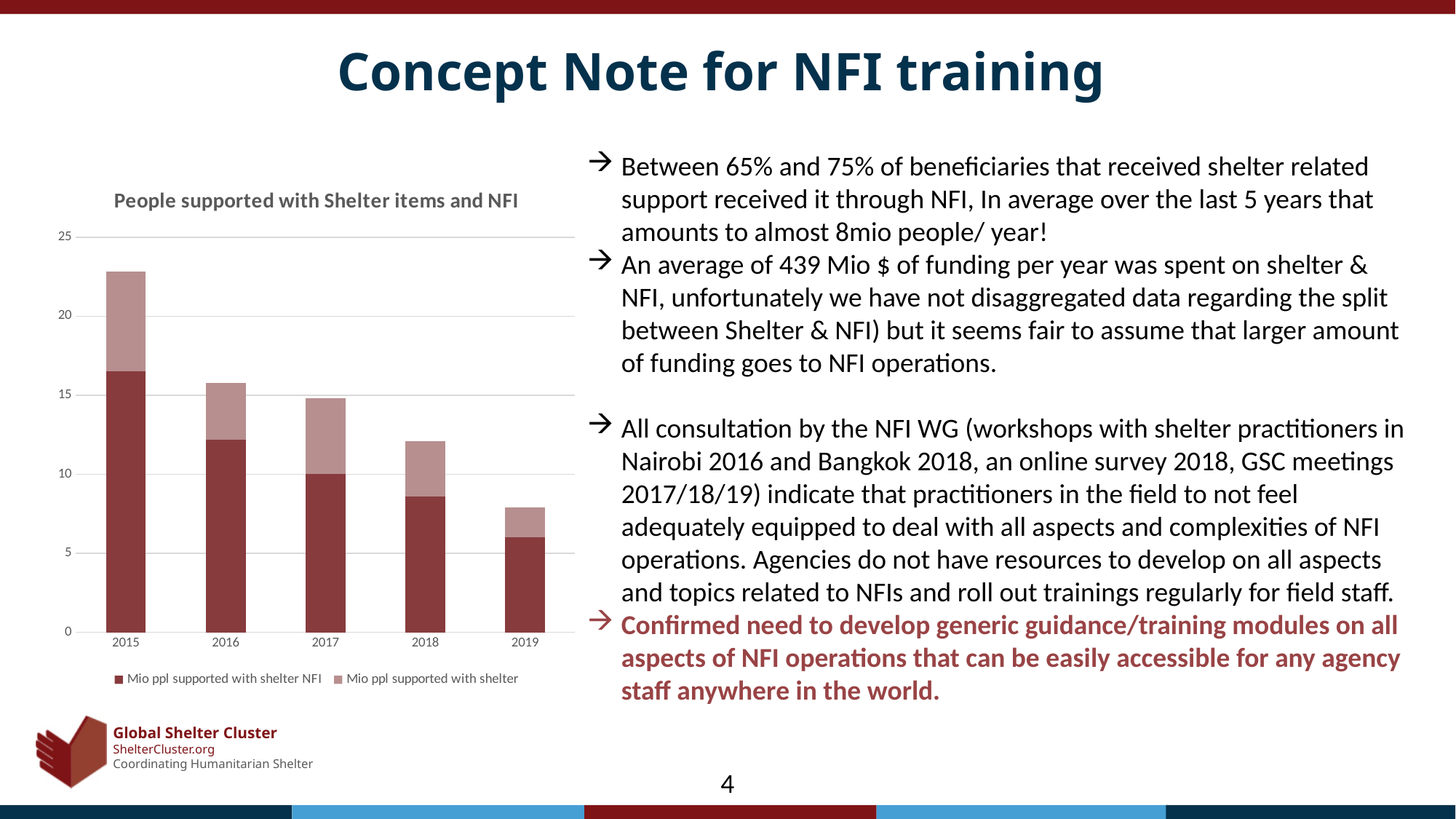
Is the total stacked bar for 2019 greater or less than 10? less Which year has the tallest stacked bar in the chart? 2015 What is the title of the chart? People supported with Shelter items and NFI Do the total bar heights rise or fall from 2015 to 2019? fall Is the value for 'Mio ppl supported with shelter NFI' in 2018 greater or less than 10? less Is the total stacked bar for 2015 greater or less than 20? greater Which year has the larger total stacked bar, 2015 or 2018? 2015 How many series does the chart legend list? 2 What kind of chart is shown on the slide? stacked bar chart Which year has the shortest stacked bar in the chart? 2019 How many years are shown on the x axis of the chart? 5